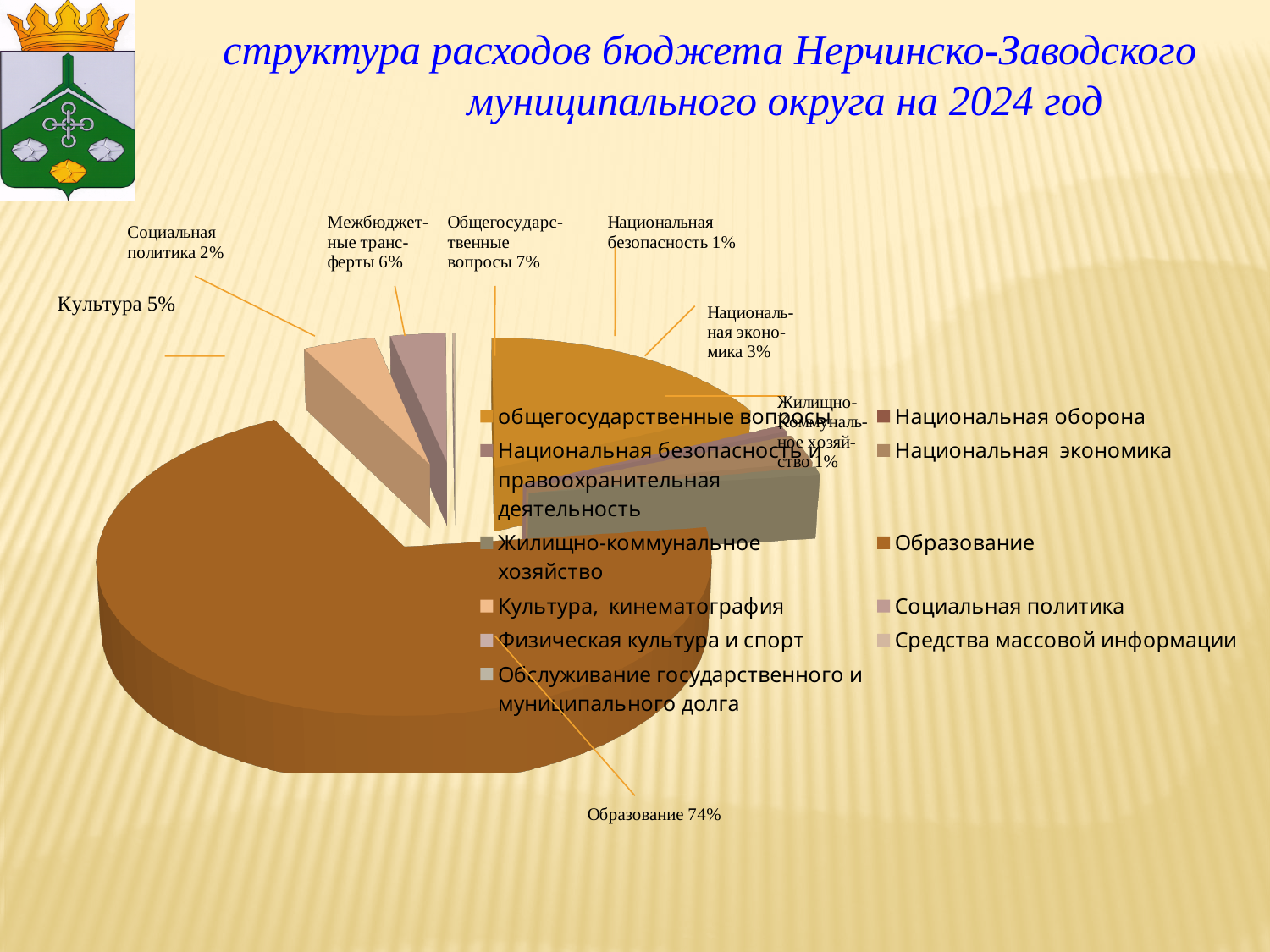
What share of the budget expenditures goes to Образование? 74% What percentage is shown for Культура? 5% Which category has the largest share of the budget expenditures? Образование Which is larger: the share for Культура or the share for Национальная экономика? Культура What percentage is shown for Общегосударственные вопросы? 7% What is the difference in percentage points between Образование and Общегосударственные вопросы? 67 What percentage is shown for Межбюджетные трансферты? 6% What percentage is shown for Национальная экономика? 3% How many entries does the legend list? 11 What percentage is shown for Социальная политика? 2% What type of chart is shown on the slide? pie chart What year does the chart title say the budget expenditure structure refers to? 2024